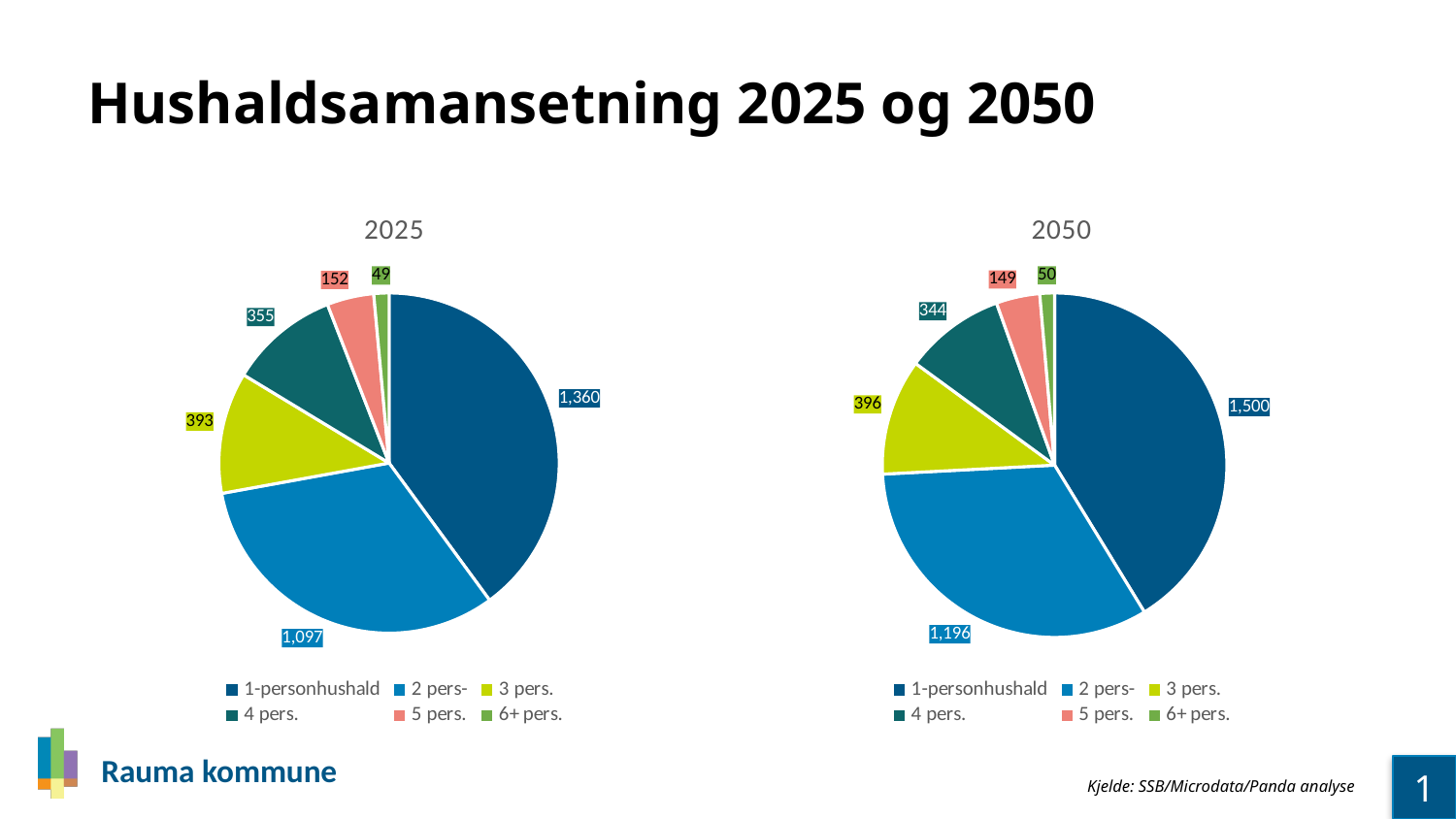
What is the difference between the 1-personhushald value in the 2050 chart and in the 2025 chart? 140 What is the title of the slide? Hushaldsamansetning 2025 og 2050 In the 2025 pie chart, what is the difference between the 3 pers. and 4 pers. values? 38 In the 2050 pie chart, what is the value for 2 pers-? 1,196 In the 2025 pie chart, what is the value for 1-personhushald? 1,360 Which is larger: the 5 pers. value in the 2025 chart or in the 2050 chart? 2025 What type of chart is used for the 2050 data? Pie chart In the 2050 pie chart, what is the value for 6+ pers.? 50 In the 2025 pie chart, which category has the smallest slice? 6+ pers. In the 2050 pie chart, which category has the largest slice? 1-personhushald In the 2025 pie chart, what is the value for 4 pers.? 355 How many categories does the 2025 pie chart show? 6